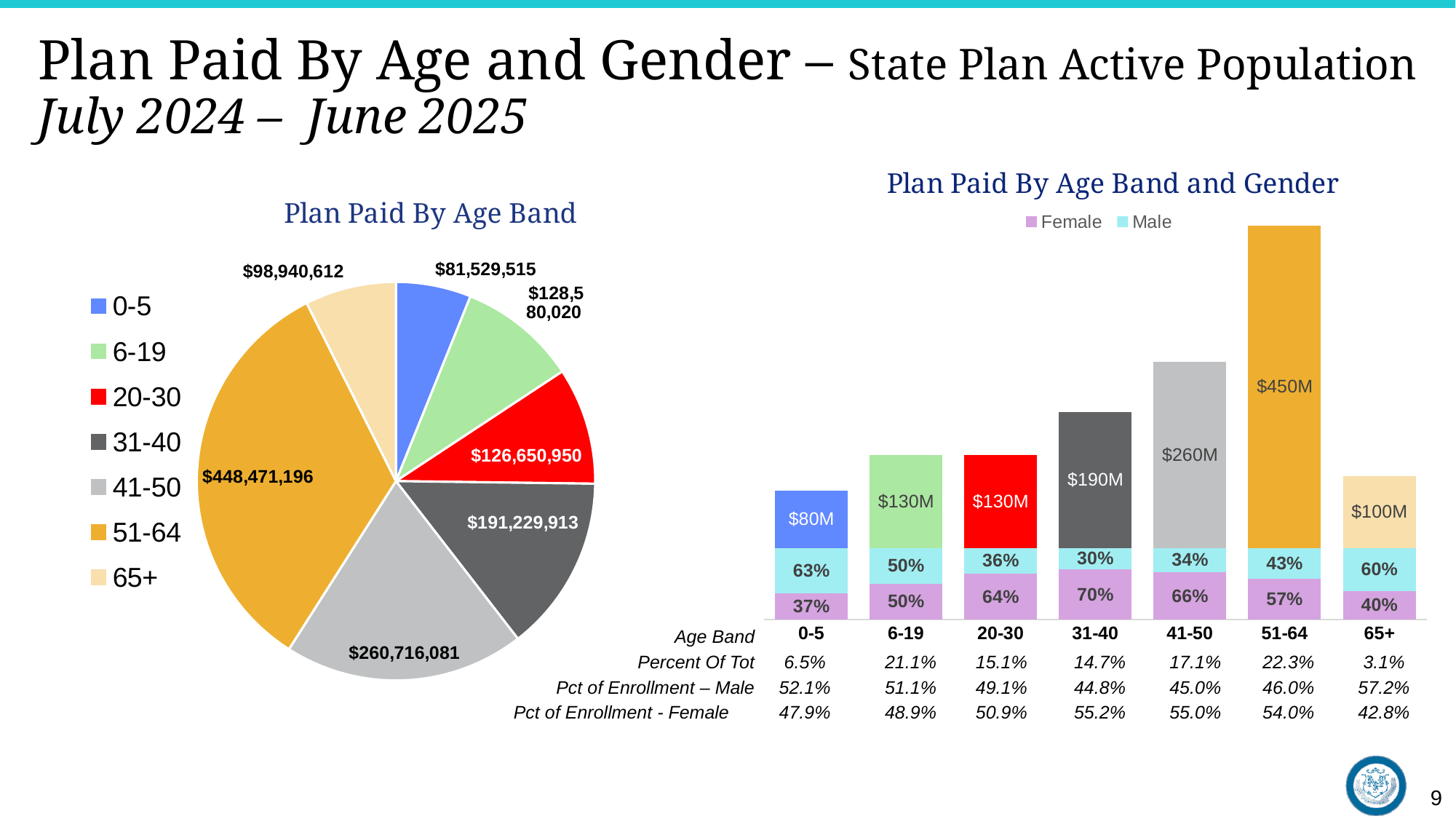
In the 'Plan Paid By Age Band and Gender' chart, what is the Male percentage for the 0-5 age band? 63% In the 'Plan Paid By Age Band' pie chart, how many age bands are shown? 7 In the 'Plan Paid By Age Band and Gender' chart, what is the plan paid amount labelled for the 51-64 age band? $450M In the 'Plan Paid By Age Band and Gender' chart, which is larger for the 65+ age band, the Female or Male percentage? Male In the 'Plan Paid By Age Band and Gender' chart, what is the Female percentage for the 31-40 age band? 70% In the 'Plan Paid By Age Band' pie chart, what is the plan paid amount for the 51-64 age band? $448,471,196 What type of chart is 'Plan Paid By Age Band'? Pie chart In the 'Plan Paid By Age Band' pie chart, which age band has the smallest slice? 0-5 In the 'Plan Paid By Age Band' pie chart, what is the plan paid amount for the 0-5 age band? $81,529,515 How many series does the legend of the 'Plan Paid By Age Band and Gender' chart list? 2 In the 'Plan Paid By Age Band' pie chart, what is the difference between the 41-50 and 31-40 amounts? $69,486,168 In the 'Plan Paid By Age Band' pie chart, which age band has the largest slice? 51-64